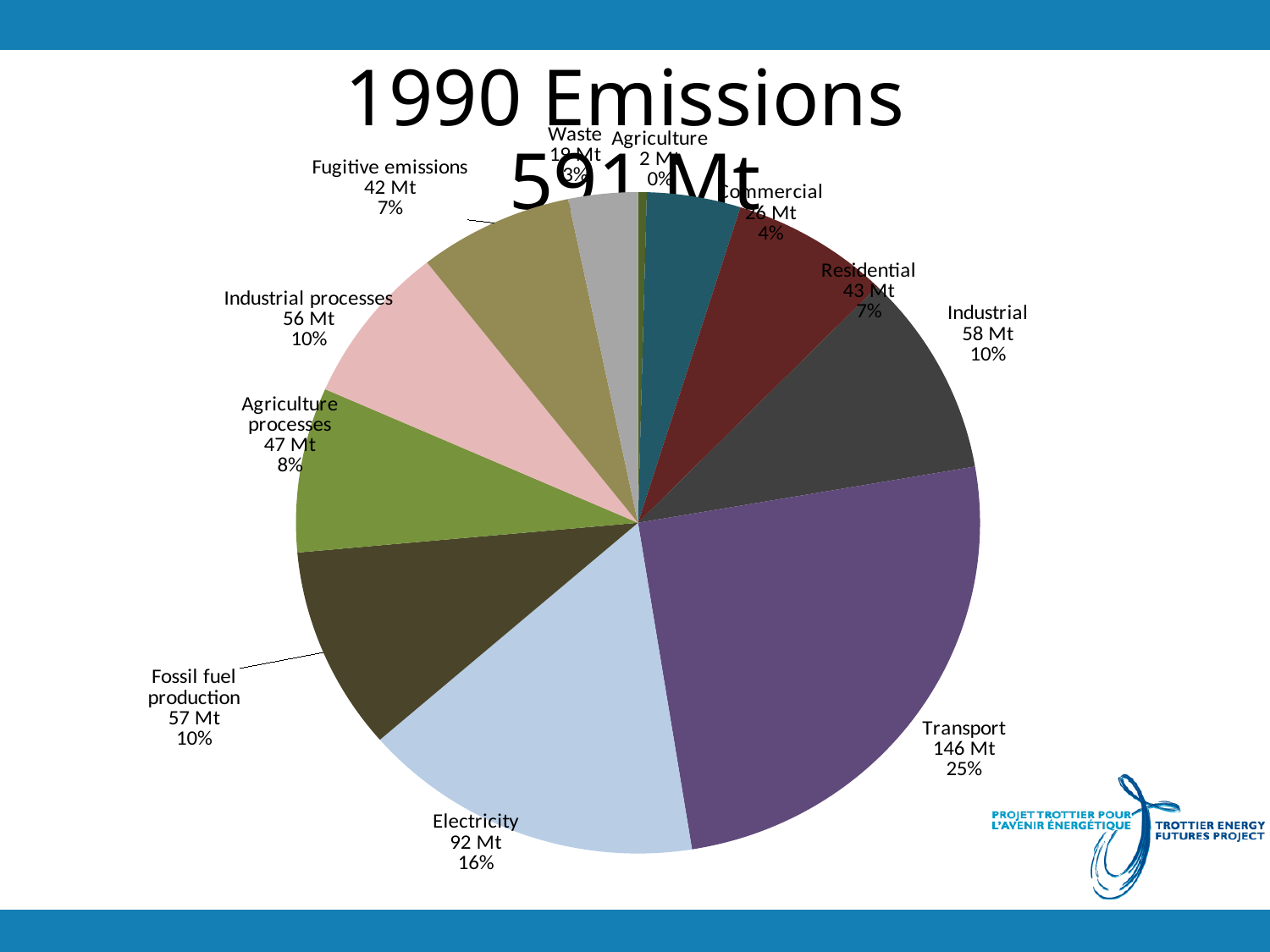
What share of the pie does Transport represent? 25% What is the title of the chart? 1990 Emissions What share of the pie does Agriculture processes represent? 8% What is the value for Electricity? 92 Mt How many categories are shown in the pie chart? 11 What is the value for Transport? 146 Mt Which category has the largest slice of the pie? Transport Which is larger, Electricity or Industrial processes? Electricity What kind of chart is shown on the slide? pie chart What is the difference between the values for Industrial and Fossil fuel production? 1 Mt Which category has the smallest slice of the pie? Agriculture What is the value for Fugitive emissions? 42 Mt